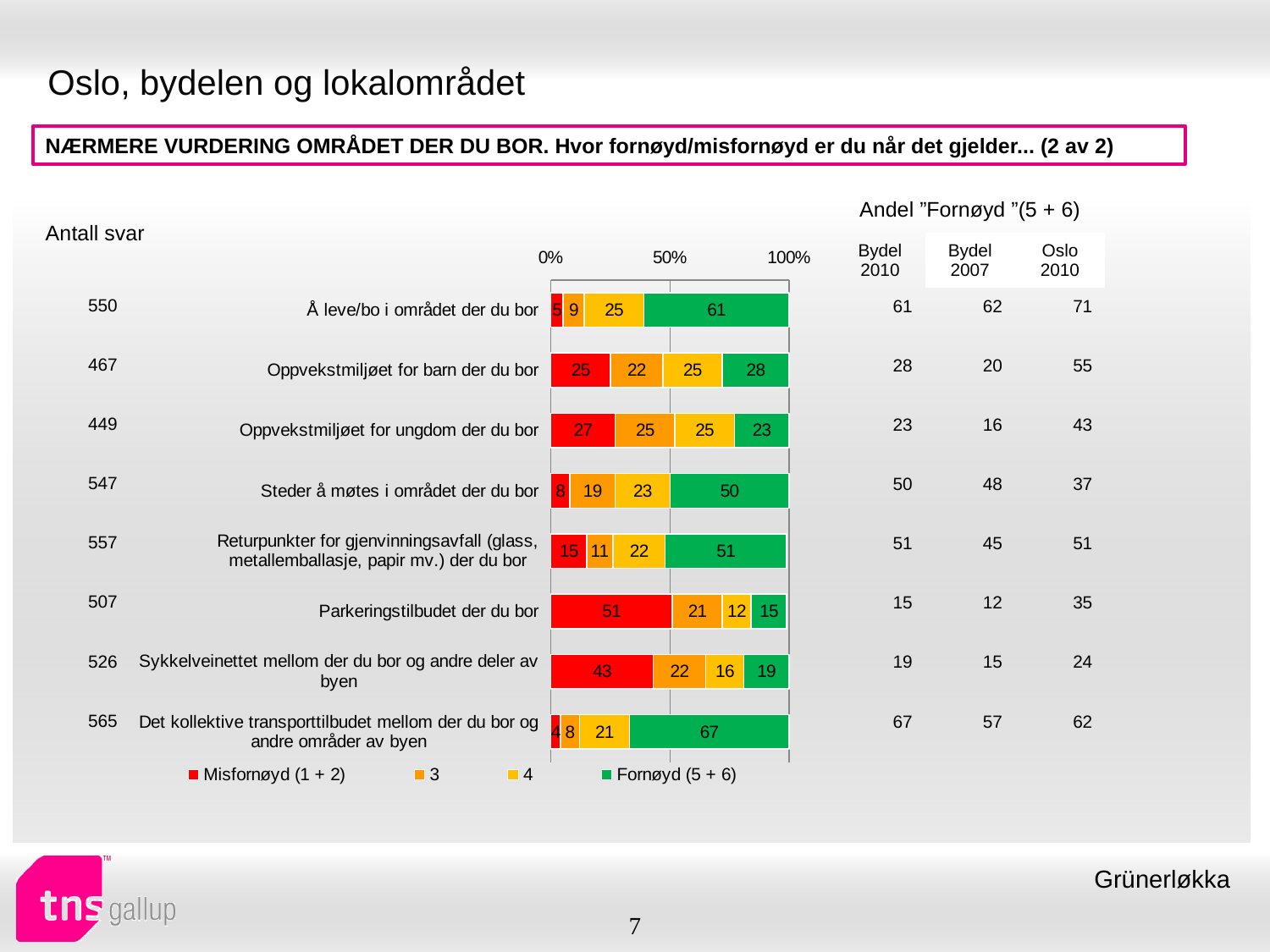
What is the difference between the Fornøyd (5 + 6) values for 'Steder å møtes i området der du bor' and 'Oppvekstmiljøet for barn der du bor'? 22 What kind of chart is shown on the slide? stacked bar chart What colour represents the Fornøyd (5 + 6) series in the chart? green How many series does the chart legend list? 4 Which category has the highest Fornøyd (5 + 6) value? Det kollektive transporttilbudet mellom der du bor og andre områder av byen What is the total of the stacked bar for 'Å leve/bo i området der du bor'? 100 How many categories (statements) are plotted in the chart? 8 Which has a larger Misfornøyd (1 + 2) value: 'Sykkelveinettet mellom der du bor og andre deler av byen' or 'Oppvekstmiljøet for ungdom der du bor'? Sykkelveinettet mellom der du bor og andre deler av byen Which category has the lowest Fornøyd (5 + 6) value? Parkeringstilbudet der du bor What is the Fornøyd (5 + 6) value for 'Å leve/bo i området der du bor'? 61 What is the Misfornøyd (1 + 2) value for 'Parkeringstilbudet der du bor'? 51 What is the value of series '3' for 'Oppvekstmiljøet for ungdom der du bor'? 25